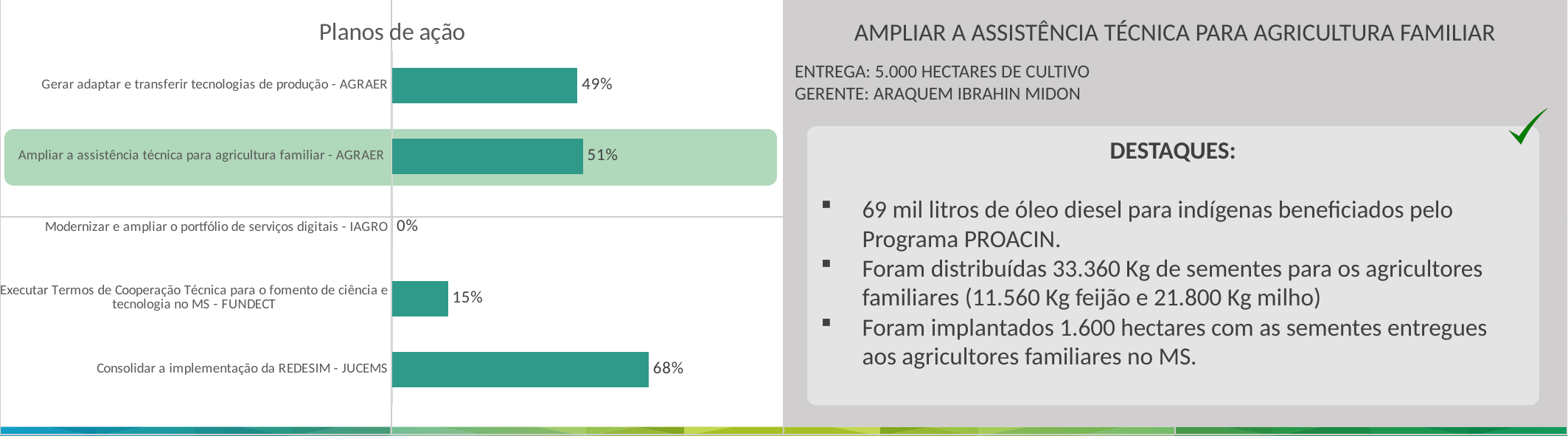
What is the difference between the values for 'Consolidar a implementação da REDESIM - JUCEMS' and 'Gerar adaptar e transferir tecnologias de produção - AGRAER'? 19% What kind of chart is shown on the slide? Bar chart How many categories are shown in the chart? 5 What is the value for 'Executar Termos de Cooperação Técnica para o fomento de ciência e tecnologia no MS - FUNDECT'? 15% Which category has the highest value? Consolidar a implementação da REDESIM - JUCEMS What is the value for 'Ampliar a assistência técnica para agricultura familiar - AGRAER'? 51% What is the value for 'Consolidar a implementação da REDESIM - JUCEMS'? 68% What is the title of the chart? Planos de ação Which category in the chart is highlighted with a green background? Ampliar a assistência técnica para agricultura familiar - AGRAER Which category has the lowest value? Modernizar e ampliar o portfólio de serviços digitais - IAGRO What is the value for 'Modernizar e ampliar o portfólio de serviços digitais - IAGRO'? 0% Which is larger: the value for 'Gerar adaptar e transferir tecnologias de produção - AGRAER' or the value for 'Executar Termos de Cooperação Técnica para o fomento de ciência e tecnologia no MS - FUNDECT'? Gerar adaptar e transferir tecnologias de produção - AGRAER